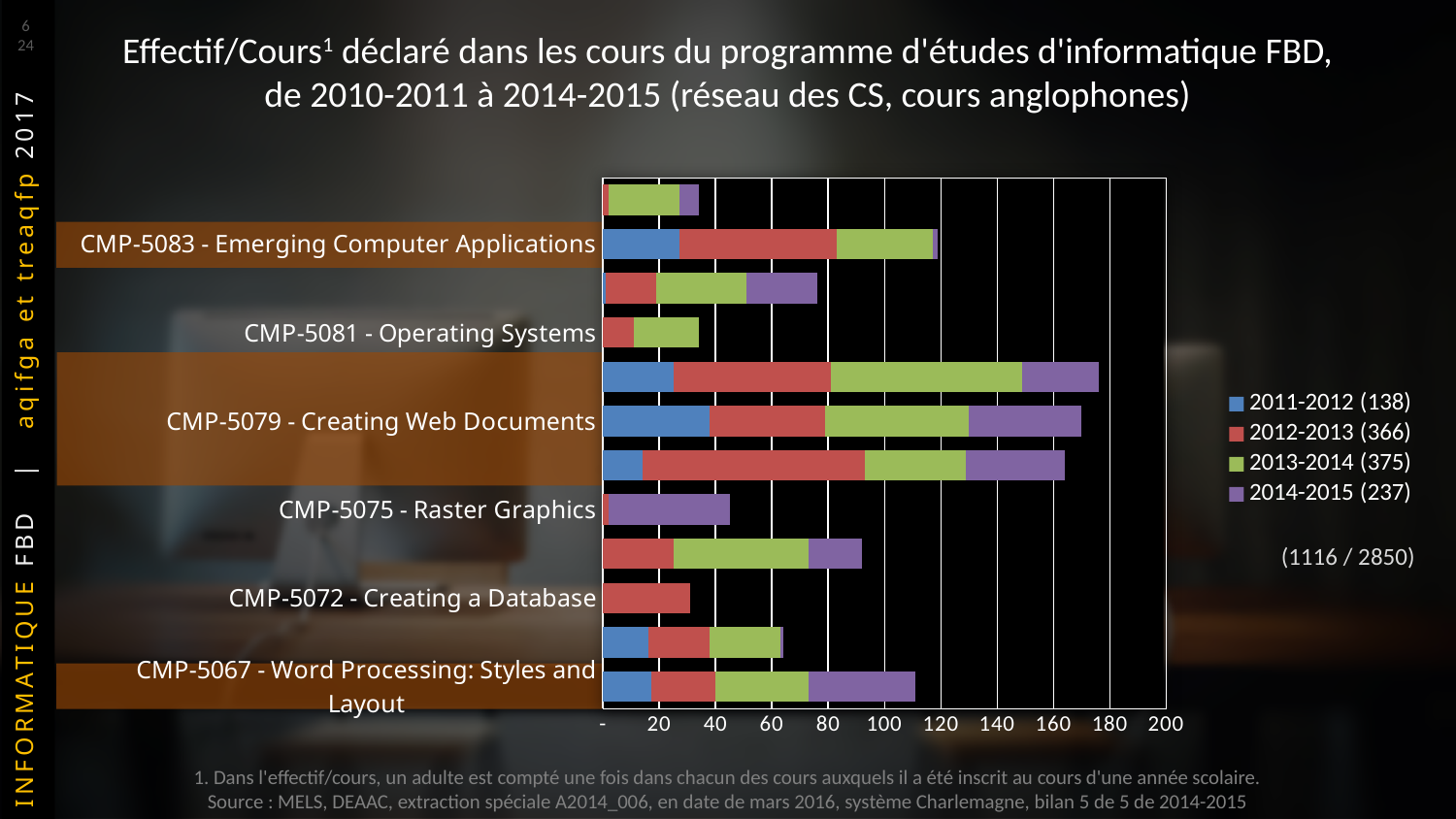
Is the total bar length for CMP-5075 - Raster Graphics greater or less than 60? less Is the total bar length for CMP-5083 - Emerging Computer Applications greater or less than 100? greater What kind of chart is shown on the slide? stacked bar chart Which school year in the legend has the highest total shown in parentheses? 2013-2014 (375) What is the highest value shown on the horizontal axis? 200 Is the total bar length for CMP-5079 - Creating Web Documents greater or less than 160? greater Which colour represents the 2012-2013 series in the legend? red Which school year in the legend has the lowest total shown in parentheses? 2011-2012 (138) What total is shown in the legend for 2014-2015? 237 Which has the longer total bar, CMP-5079 - Creating Web Documents or CMP-5081 - Operating Systems? CMP-5079 - Creating Web Documents How many series does the legend list? 4